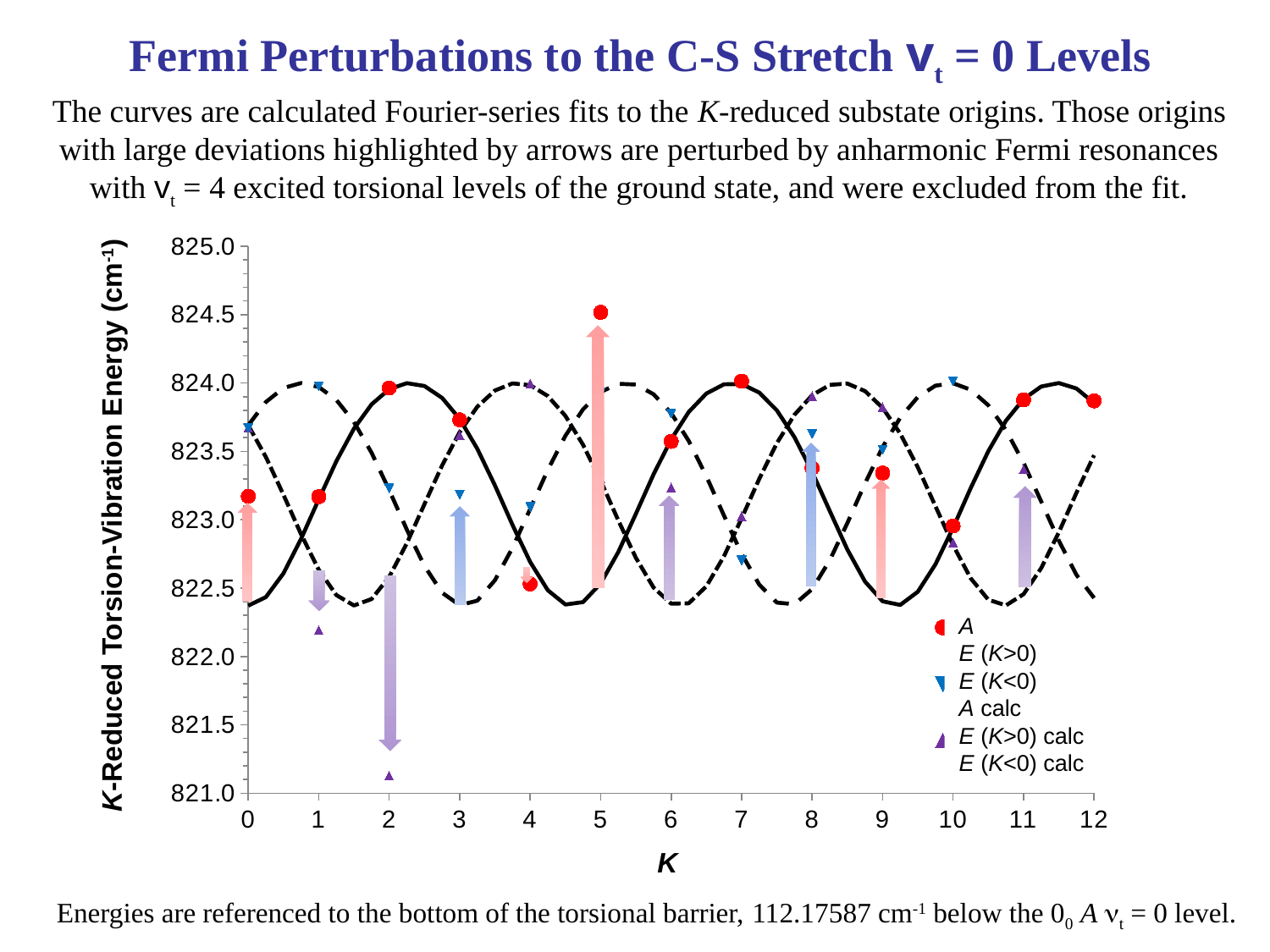
What kind of chart is shown on the slide? Scatter chart How many K values are marked on the x axis? 13 At which value of K is the E (K>0) calc series lowest? 2 At which value of K is the A series lowest? 4 Is the value of the E (K>0) calc series at K = 2 greater or less than 821.5? less Which is larger for the A series: the value at K = 2 or the value at K = 4? K = 2 Is the value of the A series at K = 10 greater or less than 823.5? less What is the label of the y axis? K-Reduced Torsion-Vibration Energy (cm-1) What is the label of the x axis? K How many series does the legend list? 6 Is the value of the A series at K = 5 greater or less than 824.0? greater At which value of K is the A series highest? 5